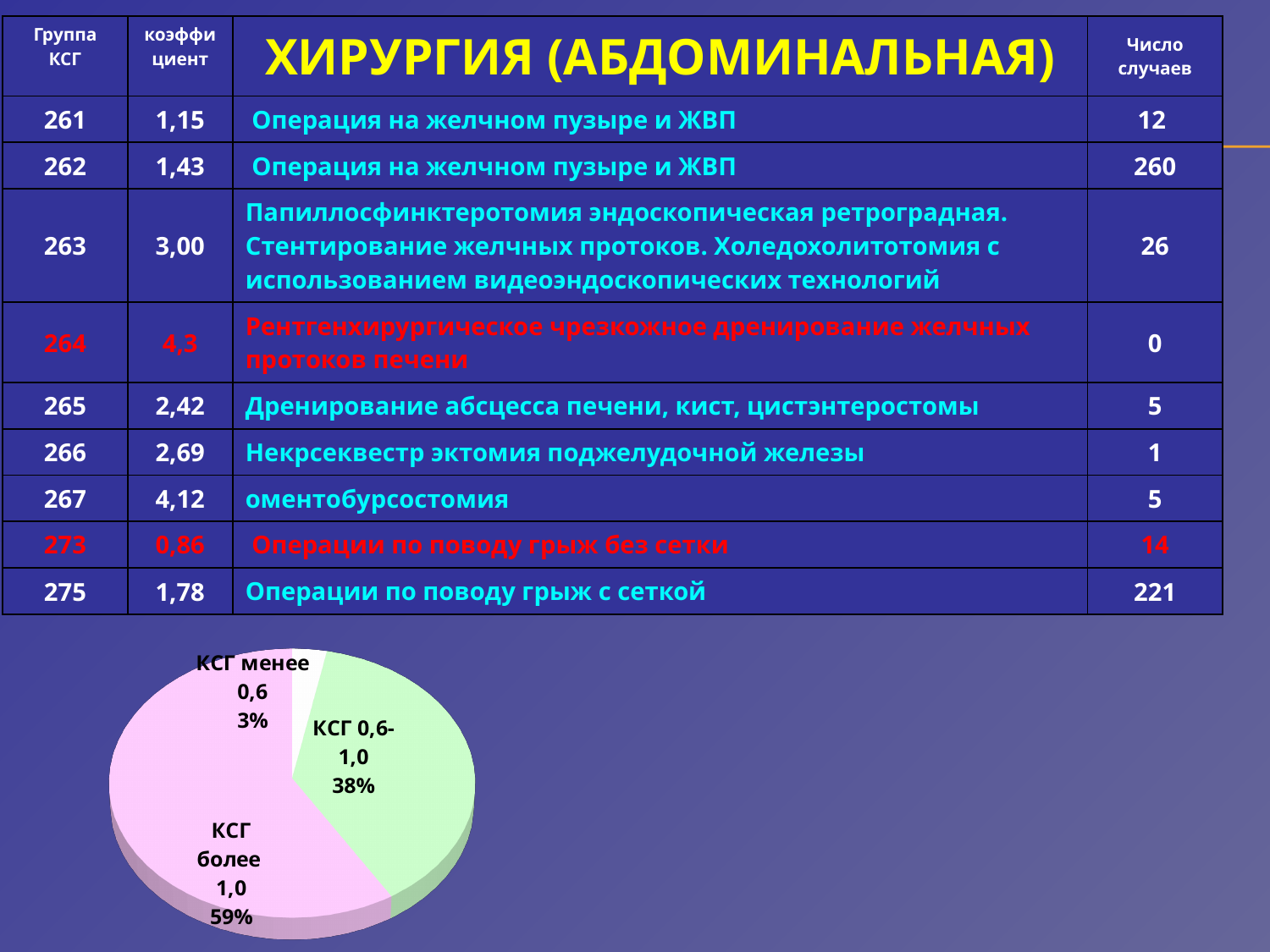
In the pie chart, what is the difference in percentage points between the "КСГ более 1,0" slice and the "КСГ 0,6-1,0" slice? 21% How many slices does the pie chart have? 3 In the pie chart, what is the combined share of the "КСГ 0,6-1,0" and "КСГ менее 0,6" slices? 41% What share of the pie chart does the slice "КСГ 0,6-1,0" take? 38% Which slice of the pie chart is the largest? КСГ более 1,0 What share of the pie chart does the slice "КСГ более 1,0" take? 59% Which slice of the pie chart is the smallest? КСГ менее 0,6 What share of the pie chart does the slice "КСГ менее 0,6" take? 3% In the pie chart, what is the difference in percentage points between the "КСГ 0,6-1,0" slice and the "КСГ менее 0,6" slice? 35% What kind of chart is shown at the bottom of the slide? pie chart In the pie chart, which is larger: the share for "КСГ 0,6-1,0" or the share for "КСГ менее 0,6"? КСГ 0,6-1,0 What colour is the largest slice of the pie chart? pink